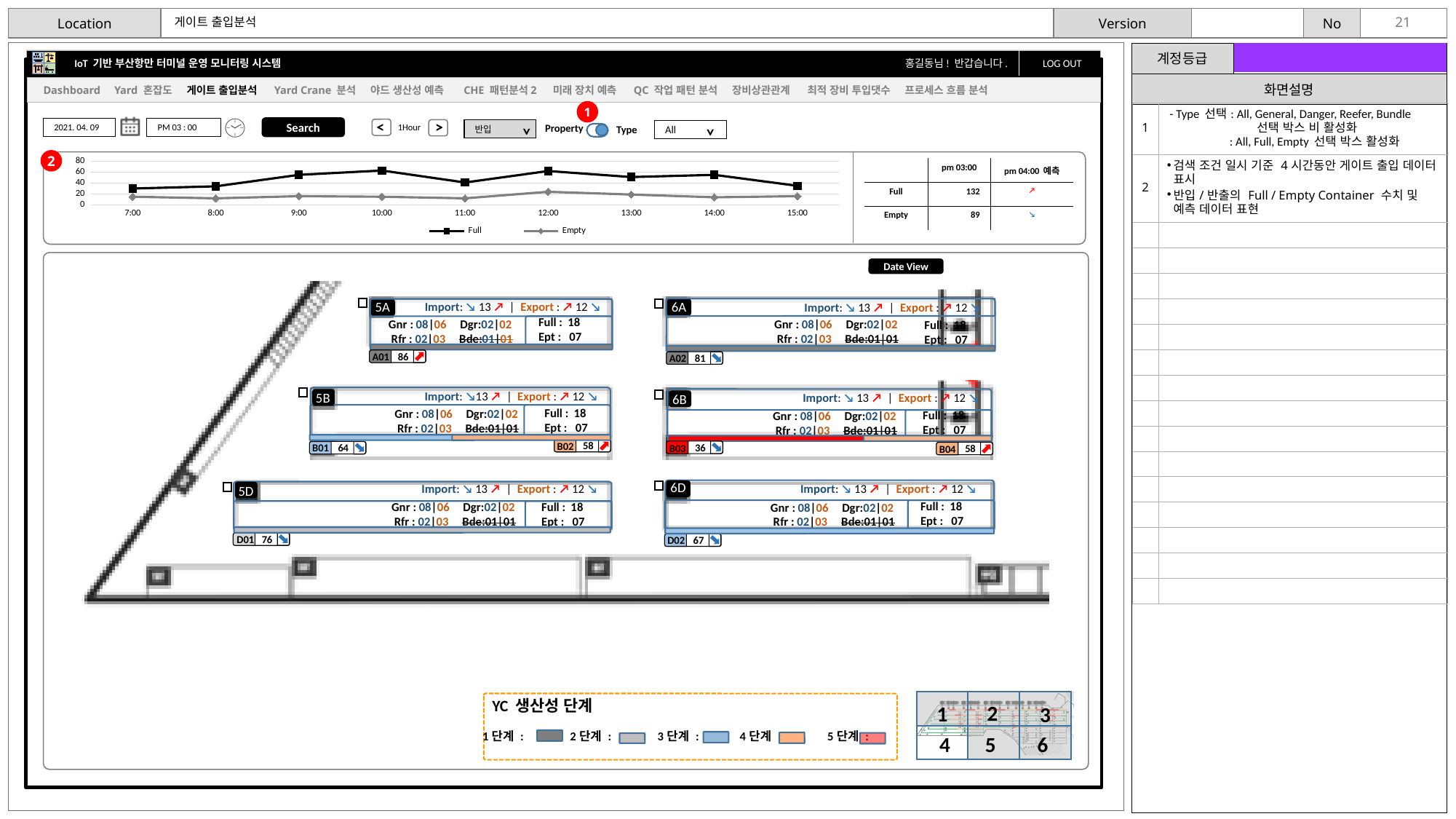
Is the Full value at 11:00 greater or less than 60? less What are the two series named in the line chart's legend? Full and Empty Does the Full series rise or fall between 10:00 and 11:00? fall Is the Full value at 9:00 greater or less than 40? greater Does the Full series rise or fall between 8:00 and 10:00? rise What is the first time label on the x axis of the line chart? 7:00 What kind of chart is shown at the top of the screen mock-up? line chart How many series does the legend of the line chart list? 2 At 12:00, which series has the larger value, Full or Empty? Full Is the Empty value at 11:00 greater or less than 20? less How many time points are plotted along the x axis of the line chart? 9